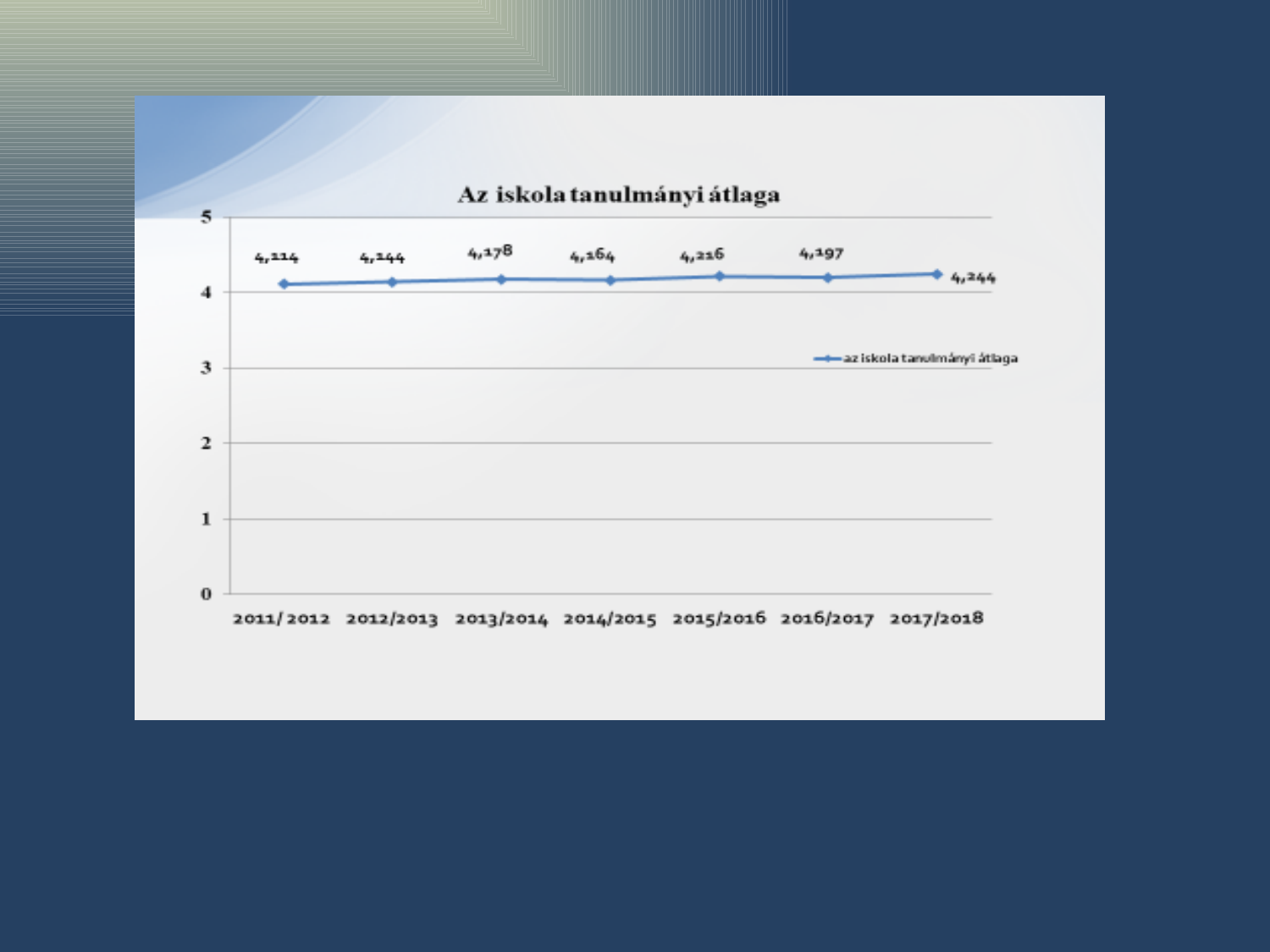
What is the value for 2011/2012? 4,114 How many school years are plotted on the x axis? 7 What is the value for 2015/2016? 4,216 Is the value for 2013/2014 greater or less than 4? greater How many series does the legend list? 1 What is the value for 2017/2018? 4,244 What is the difference between the values for 2017/2018 and 2011/2012? 0,130 Which school year has the highest value? 2017/2018 What type of chart is shown on the slide? line chart What is the title of the chart? Az iskola tanulmányi átlaga Which is larger, the value for 2015/2016 or the value for 2016/2017? 2015/2016 Which school year has the lowest value? 2011/2012